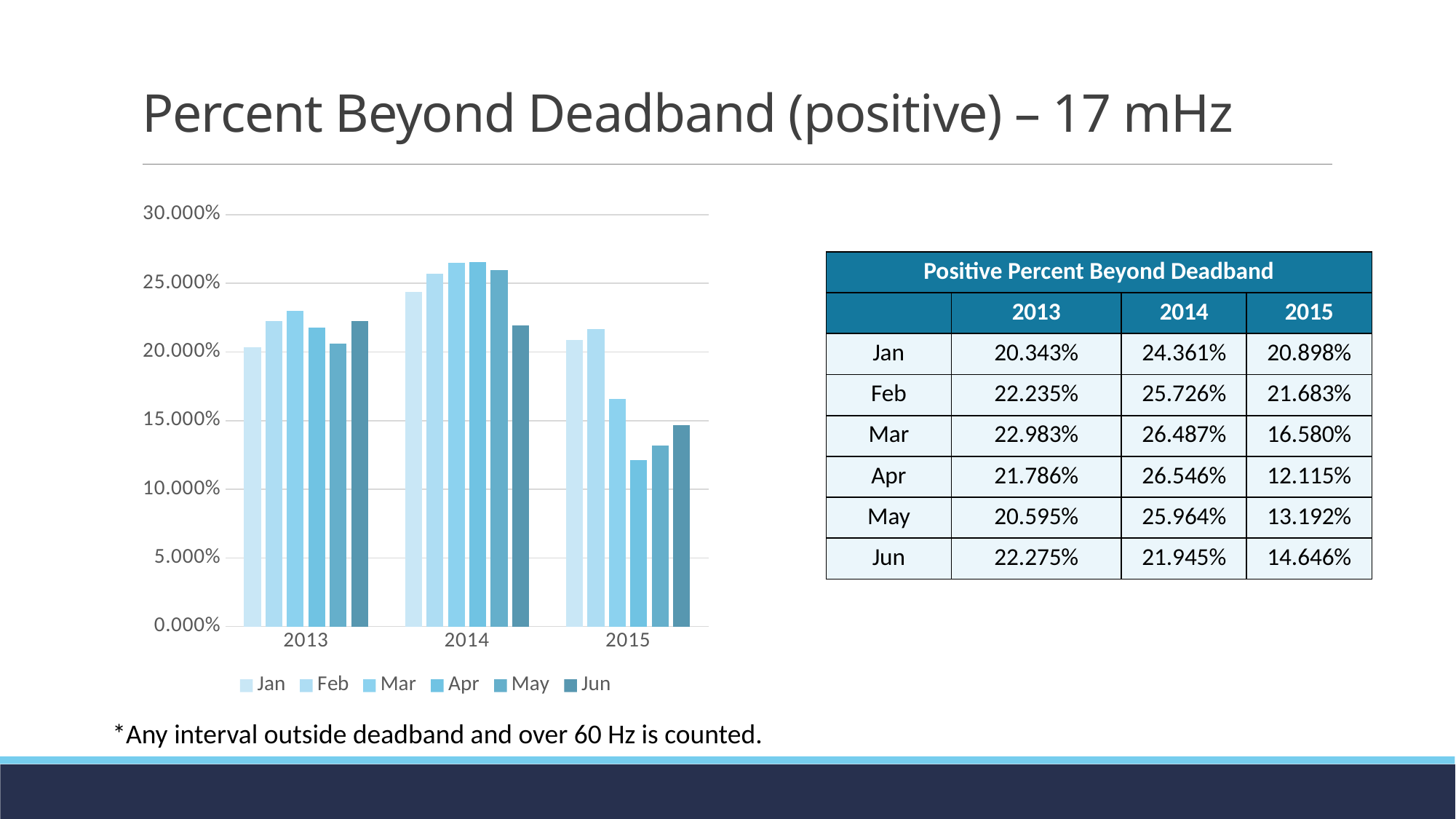
What is the value for Apr in 2014? 26.546% Is the value for Mar in 2015 greater or less than 20.000%? less Do the monthly values in 2015 generally rise or fall from Jan to Apr? fall Which month has the lowest value in 2015? Apr How many series does the chart legend list? 6 What is the value for Jan in 2013? 20.343% How many year categories are shown on the x axis of the chart? 3 What is the difference between the Jan values for 2014 and 2013? 4.018% Which is larger, the Jun value for 2013 or the Jun value for 2014? 2013 What kind of chart is shown on the slide? bar chart What is the value for Apr in 2015? 12.115% Which month has the highest value in 2013? Mar